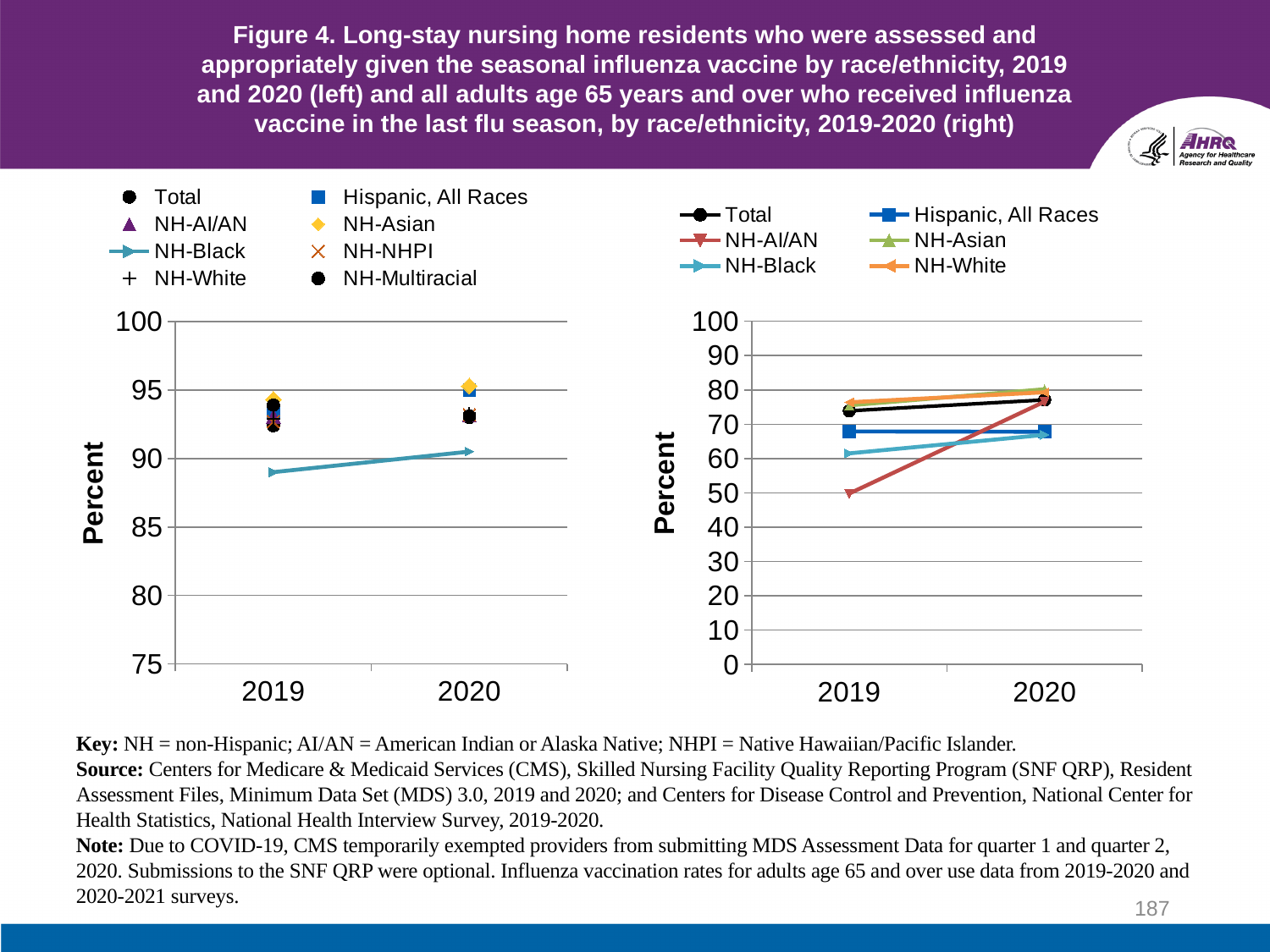
On the right chart, is the value for NH-Black in 2019 greater or less than 70? less On the right chart, which race/ethnicity group has the lowest value in 2019? NH-AI/AN On the left chart, which race/ethnicity group has the lowest value in 2019? NH-Black On the right chart, does the value for NH-AI/AN rise or fall from 2019 to 2020? rise What kind of chart is the right chart? line chart On the left chart, is the value for NH-Black in 2019 greater or less than 90? less On the right chart, how many years are shown on the x axis? 2 On the left chart, how many series does the legend list? 8 On the left chart, in 2020, which is larger: NH-Asian or NH-Black? NH-Asian On the right chart, in 2019, which is larger: Hispanic, All Races or NH-Black? Hispanic, All Races On the right chart, how many series does the legend list? 6 On the right chart, is the value for NH-AI/AN in 2019 greater or less than 60? less